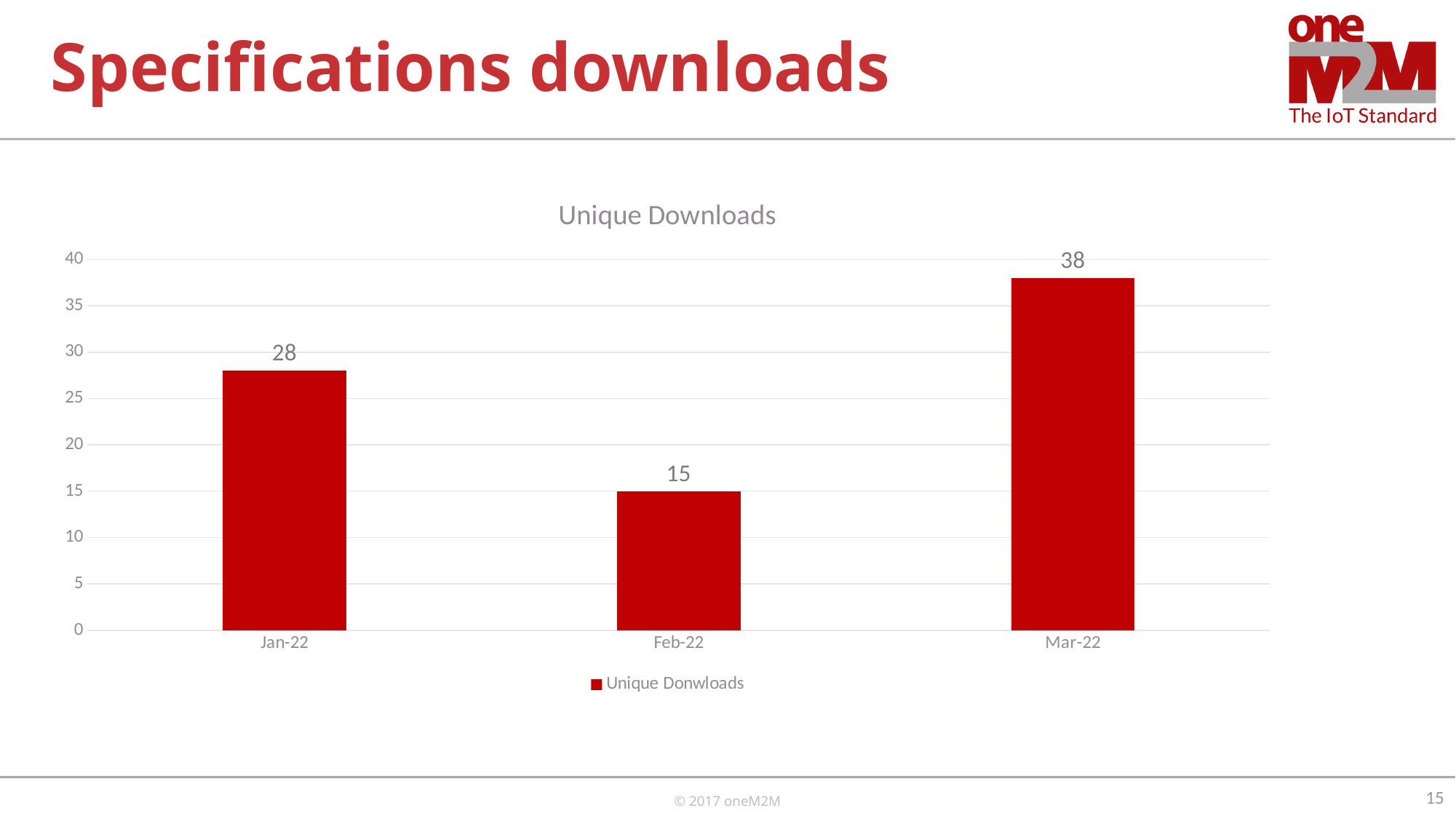
How many months are shown on the x axis? 3 What is the difference between the values for Mar-22 and Jan-22? 10 What is the value for Jan-22? 28 What is the value for Feb-22? 15 Which is larger, the value for Jan-22 or the value for Feb-22? Jan-22 What is the difference between the values for Jan-22 and Feb-22? 13 Which month has the highest number of unique downloads? Mar-22 What is the title of the chart? Unique Downloads What kind of chart is shown on the slide? Bar chart What is the value for Mar-22? 38 Is the value for Mar-22 greater or less than 35? greater Which month has the lowest number of unique downloads? Feb-22